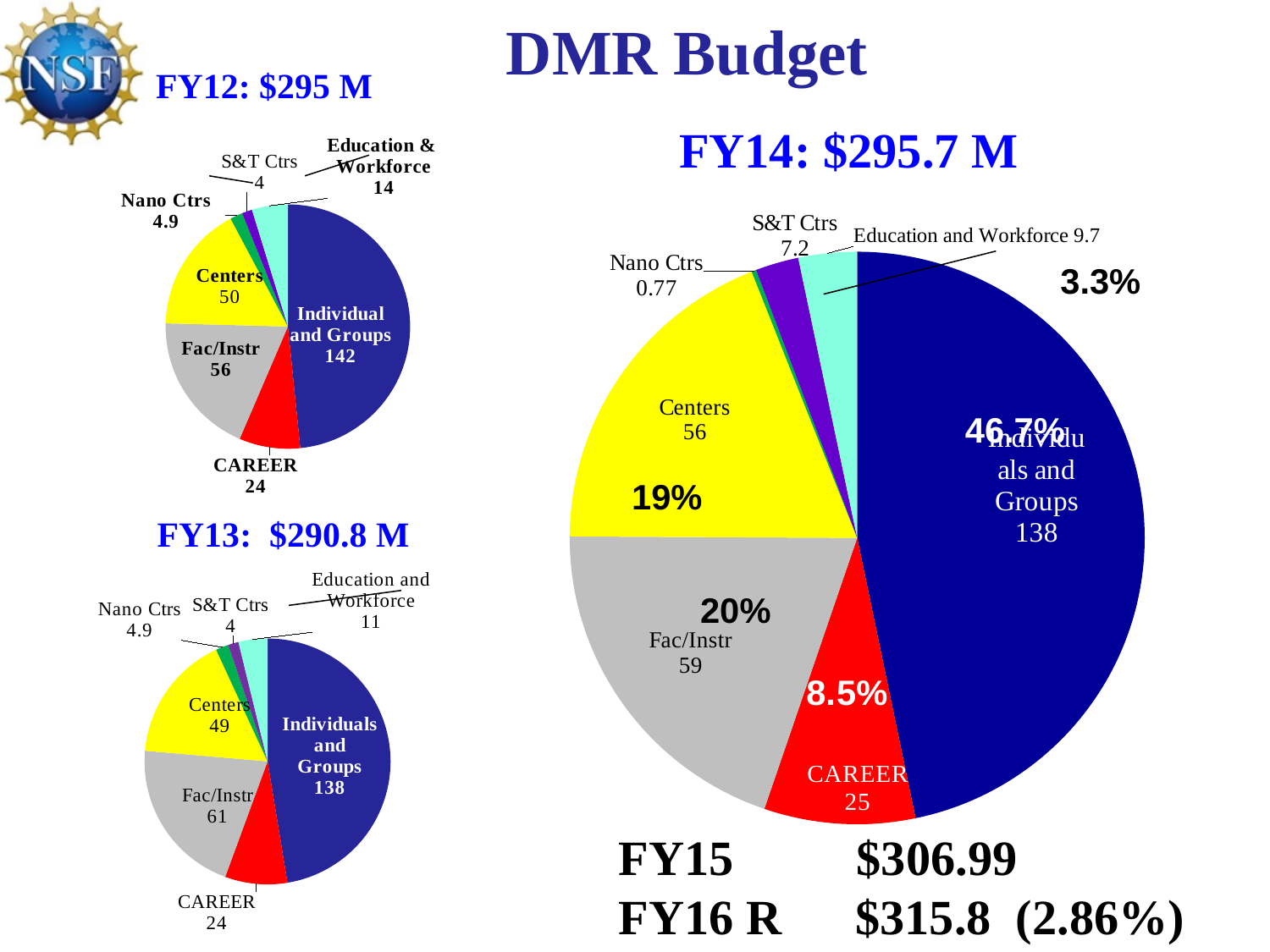
In the FY14: $295.7 M pie chart, what percentage share is shown for CAREER? 8.5% How many pie charts are on the slide? 3 In the FY14: $295.7 M pie chart, which is larger, Centers or Fac/Instr? Fac/Instr In the FY12: $295 M pie chart, what is the value for Fac/Instr? 56 In the FY13: $290.8 M pie chart, what is the value for Centers? 49 In the FY14: $295.7 M pie chart, which category has the largest slice? Individuals and Groups In the FY14: $295.7 M pie chart, what is the value for Education and Workforce? 9.7 How many categories does the FY13: $290.8 M pie chart show? 7 What kind of chart is used for the FY14: $295.7 M budget? Pie chart In the FY12: $295 M pie chart, which category has the smallest value? S&T Ctrs In the FY13: $290.8 M pie chart, what is the difference between Fac/Instr and Centers? 12 In the FY14: $295.7 M pie chart, which category has the smallest slice? Nano Ctrs